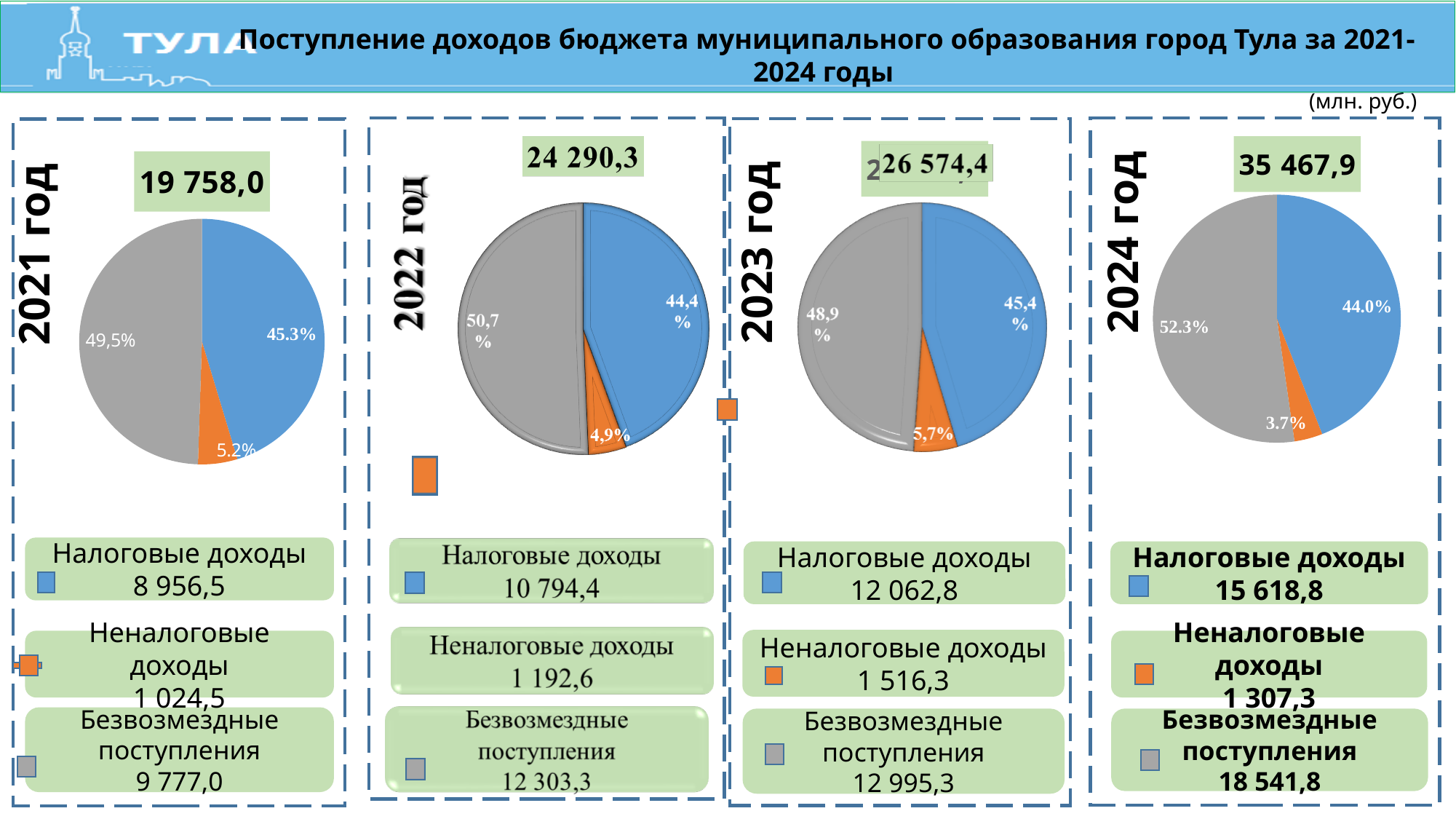
How many slices does each pie chart on the slide have? 3 In the 2022 год pie chart, what share of the pie is Безвозмездные поступления? 50,7% In the 2023 год chart, what is the value for Безвозмездные поступления? 12 995,3 Do the total revenue figures shown above the pie charts rise or fall from 2021 to 2024? rise What type of chart is used for each year on the slide? pie chart In the 2024 год chart, what is the value for Налоговые доходы? 15 618,8 In the 2023 год pie chart, what share of the pie is Неналоговые доходы? 5,7% In the 2022 год pie chart, which is larger: Налоговые доходы or Безвозмездные поступления? Безвозмездные поступления In the 2024 год chart, what is the difference between Безвозмездные поступления and Налоговые доходы? 2 923,0 In the 2021 год pie chart, which category has the smallest slice? Неналоговые доходы In the 2021 год pie chart, what share of the pie is Налоговые доходы? 45.3% In the 2024 год pie chart, which category has the largest slice? Безвозмездные поступления